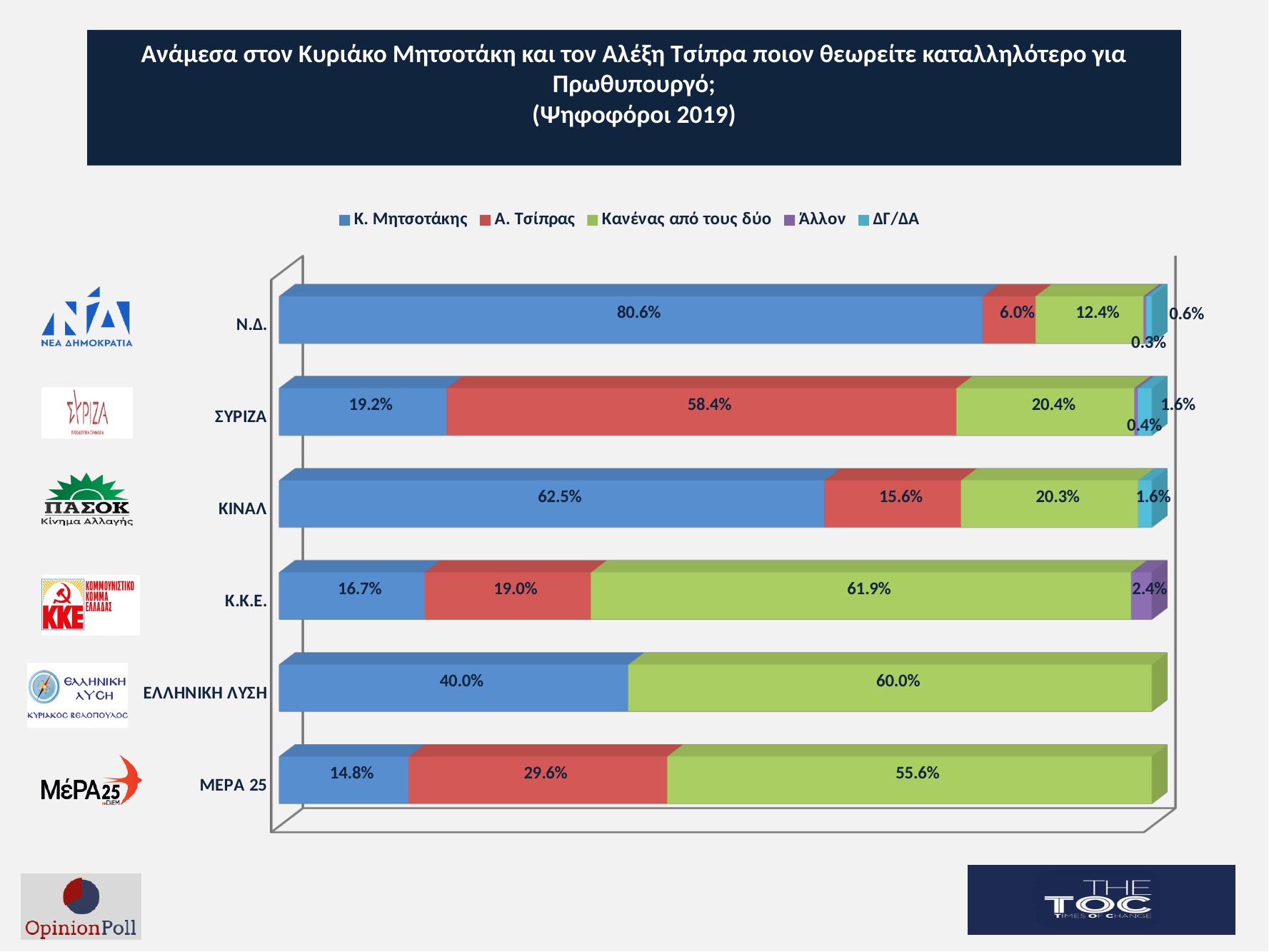
Which party's voters have the lowest value for Κ. Μητσοτάκης? ΜΕΡΑ 25 How many series does the legend list? 5 What is the difference between the Κ. Μητσοτάκης value for ΚΙΝΑΛ voters and for ΣΥΡΙΖΑ voters? 43.3% How many parties (categories) are shown in the chart? 6 What percentage of Ν.Δ. voters chose Κ. Μητσοτάκης? 80.6% What percentage of ΣΥΡΙΖΑ voters chose Α. Τσίπρας? 58.4% What is the value for ΔΓ/ΔΑ among ΚΙΝΑΛ voters? 1.6% What is the value for Κανένας από τους δύο among Κ.Κ.Ε. voters? 61.9% What kind of chart is shown on the slide? Stacked bar chart Which party's voters have the highest value for Κ. Μητσοτάκης? Ν.Δ. Among ΜΕΡΑ 25 voters, which is larger: the value for Α. Τσίπρας or for Κανένας από τους δύο? Κανένας από τους δύο Which colour represents Α. Τσίπρας in the chart? Red